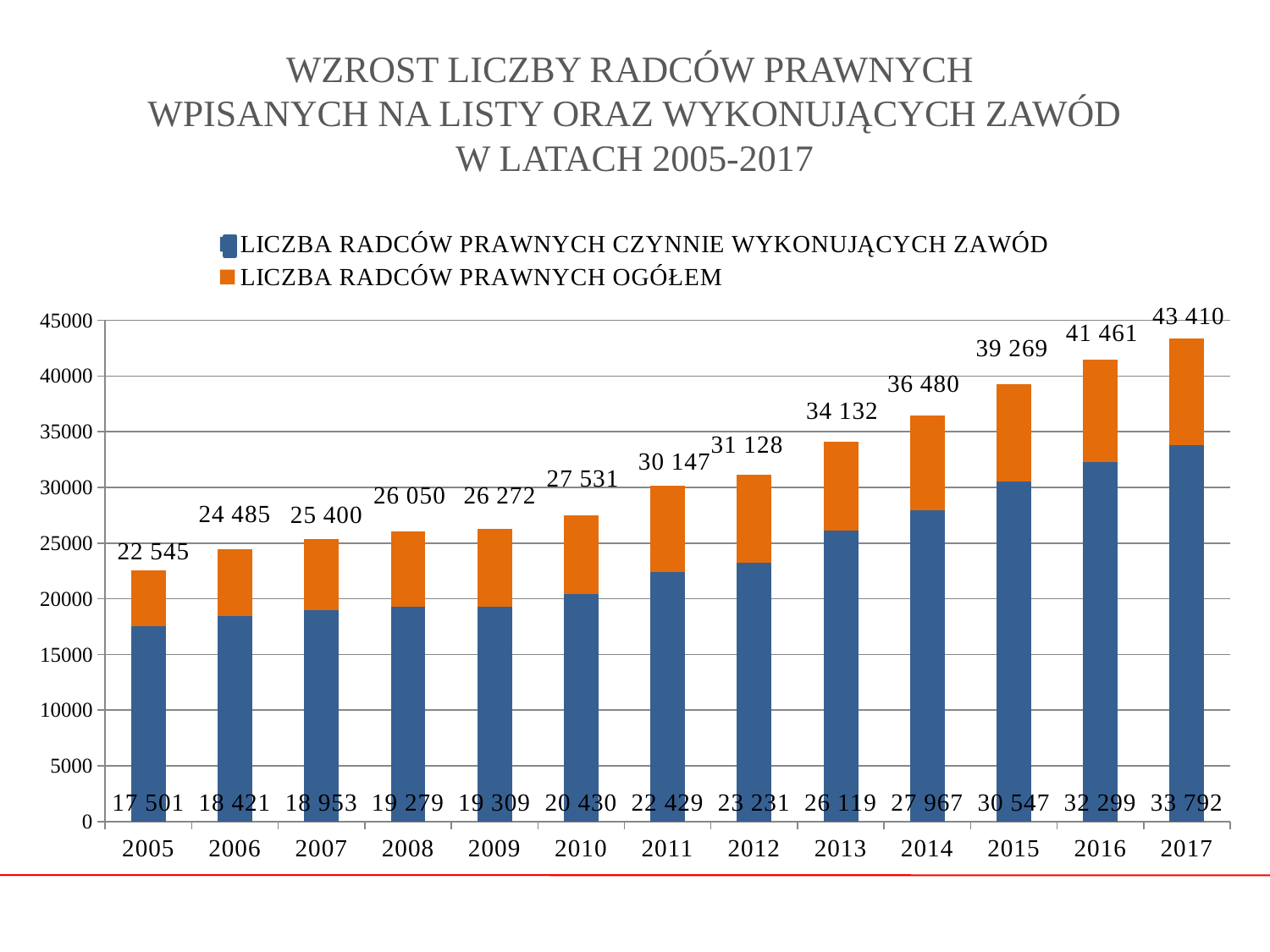
How many years are shown on the x axis? 13 What is the value for LICZBA RADCÓW PRAWNYCH CZYNNIE WYKONUJĄCYCH ZAWÓD in 2005? 17 501 What is the difference between the LICZBA RADCÓW PRAWNYCH CZYNNIE WYKONUJĄCYCH ZAWÓD values for 2017 and 2005? 16 291 Which year has the highest value for LICZBA RADCÓW PRAWNYCH OGÓŁEM? 2017 Which year has the lowest value for LICZBA RADCÓW PRAWNYCH CZYNNIE WYKONUJĄCYCH ZAWÓD? 2005 What is the value for LICZBA RADCÓW PRAWNYCH OGÓŁEM in 2017? 43 410 Which is larger: the LICZBA RADCÓW PRAWNYCH CZYNNIE WYKONUJĄCYCH ZAWÓD value for 2015 or the LICZBA RADCÓW PRAWNYCH OGÓŁEM value for 2011? LICZBA RADCÓW PRAWNYCH CZYNNIE WYKONUJĄCYCH ZAWÓD value for 2015 What is the value for LICZBA RADCÓW PRAWNYCH OGÓŁEM in 2010? 27 531 Do the values for LICZBA RADCÓW PRAWNYCH OGÓŁEM rise or fall from 2005 to 2017? rise What type of chart is shown on the slide? bar chart How many series does the legend list? 2 What is the value for LICZBA RADCÓW PRAWNYCH CZYNNIE WYKONUJĄCYCH ZAWÓD in 2012? 23 231